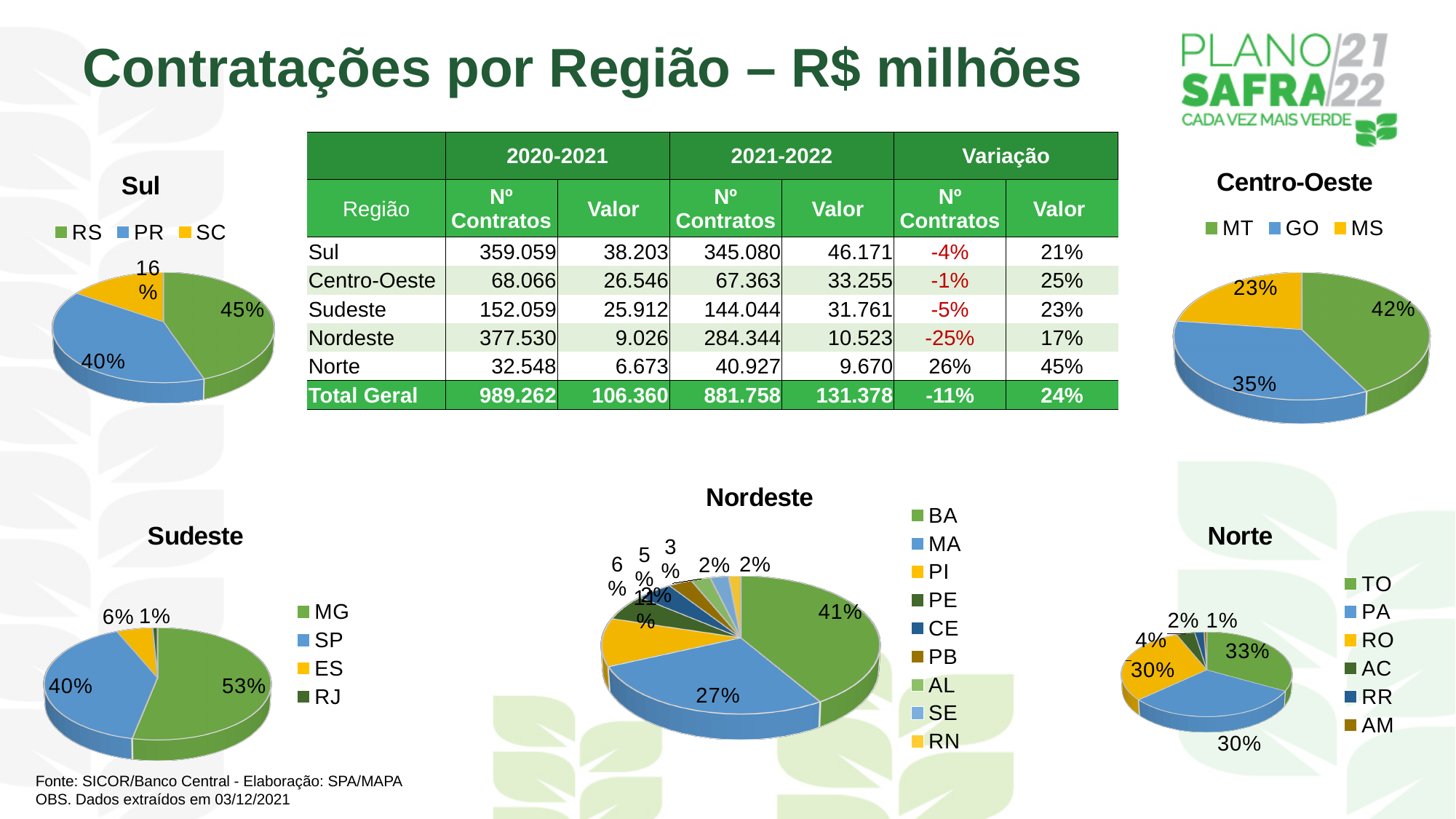
What type of chart is used for the Norte region? Pie chart In the Sudeste pie chart, what share does MG have? 53% In the Centro-Oeste pie chart, what is the difference between the shares of MT and MS? 19% In the Sudeste pie chart, which is larger, the share of SP or the share of ES? SP In the Sudeste pie chart, how many states are shown in the legend? 4 In the Nordeste pie chart, what share does BA have? 41% In the Centro-Oeste pie chart, which state has the largest share? MT In the Sul pie chart, what share does RS have? 45% In the Nordeste pie chart, how many states are listed in the legend? 9 In the Sul pie chart, which state has the smallest share? SC In the Norte pie chart, what share does TO have? 33% In the Centro-Oeste pie chart, what share does GO have? 35%